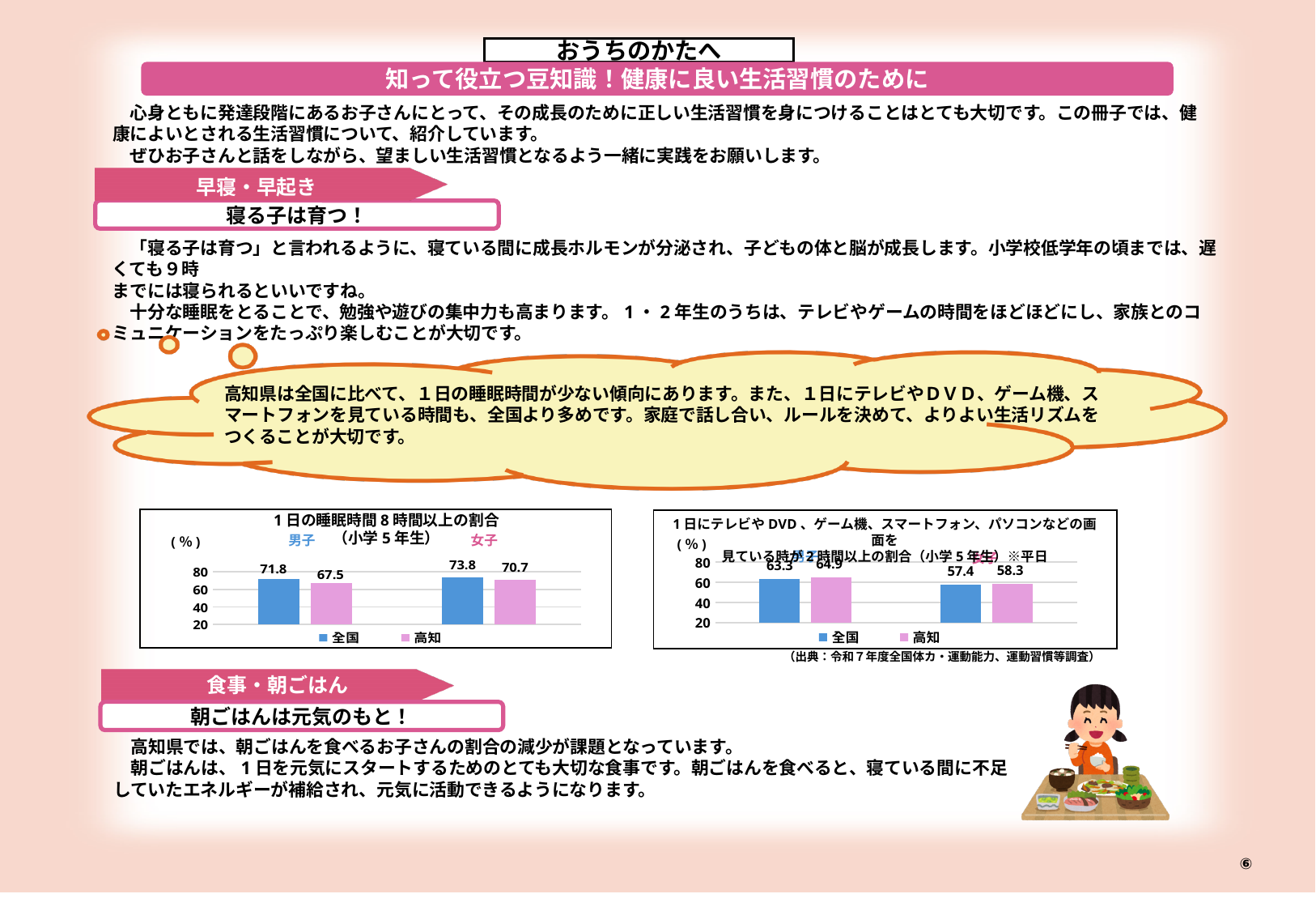
What kind of chart is the left chart (1日の睡眠時間8時間以上の割合)? Bar chart In the left chart (1日の睡眠時間8時間以上の割合), what is the difference between 全国 and 高知 among 男子? 4.3 In the left chart (1日の睡眠時間8時間以上の割合), what is the value for 全国 among 男子? 71.8 In the left chart (1日の睡眠時間8時間以上の割合), which bar is the highest? 全国 (女子), 73.8 In the left chart (1日の睡眠時間8時間以上の割合), how many series does the legend list? 2 In the right chart (screen time 2時間以上の割合), what colour represents 高知 in the legend? Pink In the left chart (1日の睡眠時間8時間以上の割合), what is the value for 高知 among 女子? 70.7 In the right chart (screen time 2時間以上の割合), which is larger in the left pair of bars, 全国 or 高知? 高知 In the right chart (screen time 2時間以上の割合), what is the difference between 高知 and 全国 in the right pair of bars? 0.9 In the right chart (screen time 2時間以上の割合), what is the value for 全国 in the right pair of bars? 57.4 In the right chart (screen time 2時間以上の割合), what is the value for 高知 in the left pair of bars? 64.9 In the left chart (1日の睡眠時間8時間以上の割合), which bar is the lowest? 高知 (男子), 67.5